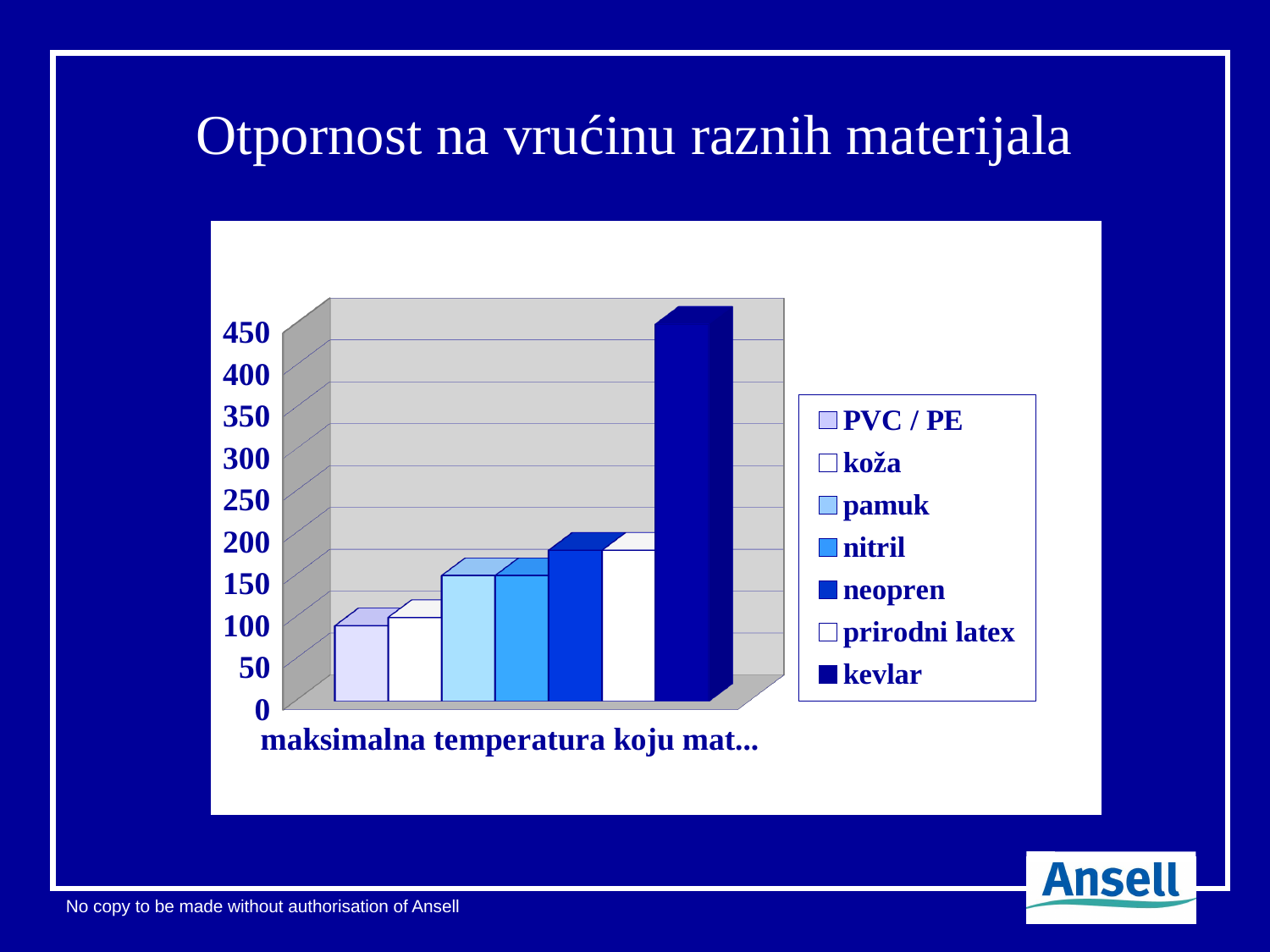
How many series does the legend list? 7 What is the title of the slide containing the chart? Otpornost na vrućinu raznih materijala Is the value for neopren greater or less than 250? less Which material has the highest bar? kevlar Is the value for kevlar greater or less than 400? greater Is the value for pamuk greater or less than 100? greater Which is larger, the value for neopren or the value for koža? neopren What kind of chart is shown on the slide? bar chart Which entry is listed last in the chart legend? kevlar Which is larger, the value for pamuk or the value for PVC / PE? pamuk Which is larger, the value for kevlar or the value for neopren? kevlar